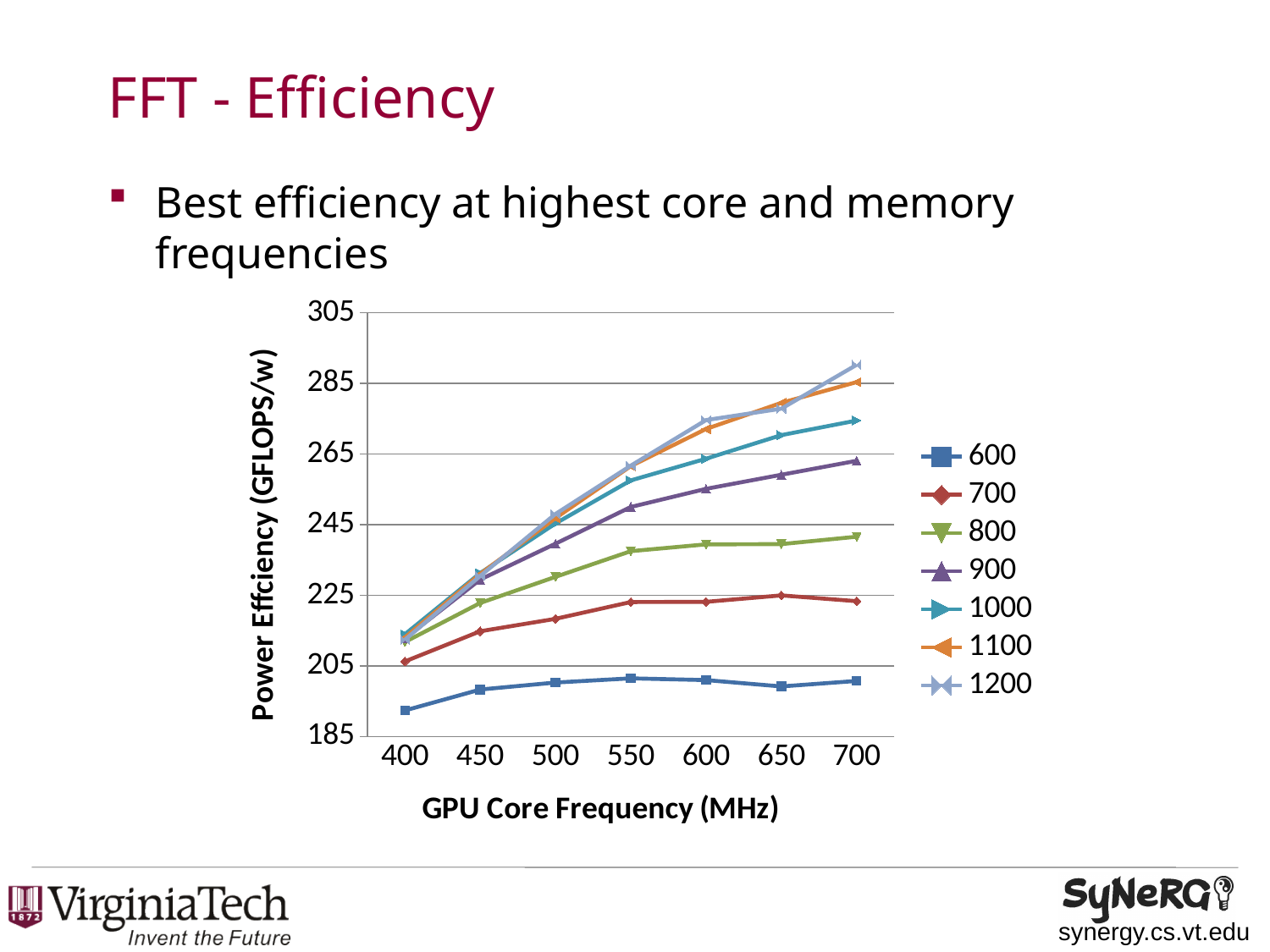
Is the value for the 1000 series at 700 MHz greater or less than 265? greater Which series has the lowest power efficiency at 700 MHz? 600 Which series has the highest power efficiency at 700 MHz? 1200 What kind of chart is shown on the slide? line chart Is the value for the 1200 series at 700 MHz greater or less than 285? greater At 400 MHz, which is larger: the value for the 600 series or the 700 series? 700 How many GPU core frequency points are plotted along the x axis? 7 Is the value for the 600 series at 400 MHz greater or less than 205? less Does the 1200 series rise or fall as GPU core frequency increases from 400 to 700 MHz? rise What is the title of the y axis? Power Effciency (GFLOPS/w) How many series does the legend list? 7